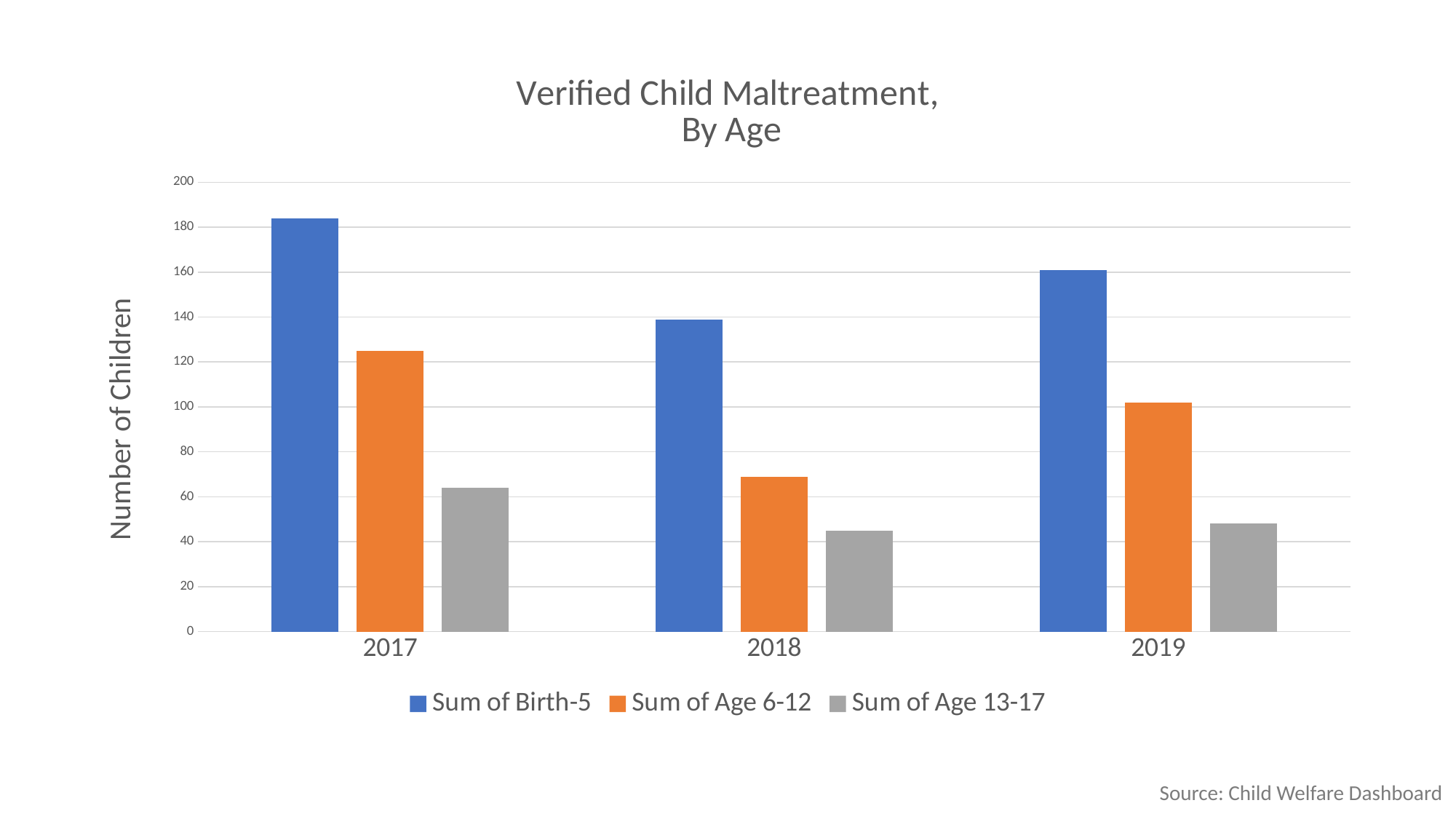
How many series does the legend list? 3 Is the value for Sum of Age 13-17 in 2019 greater or less than 60? less Is the value for Sum of Age 6-12 in 2019 greater or less than 80? greater Which year has the highest value for Sum of Birth-5? 2017 Which is larger, Sum of Age 6-12 in 2017 or Sum of Age 6-12 in 2018? 2017 Which year has the lowest value for Sum of Age 13-17? 2018 What is the label on the vertical axis? Number of Children What type of chart is shown on the slide? bar chart How many years are shown on the x axis? 3 Is the value for Sum of Birth-5 in 2017 greater or less than 160? greater Does the value for Sum of Birth-5 rise or fall from 2017 to 2018? fall Which age group has the lowest value in 2019? Sum of Age 13-17